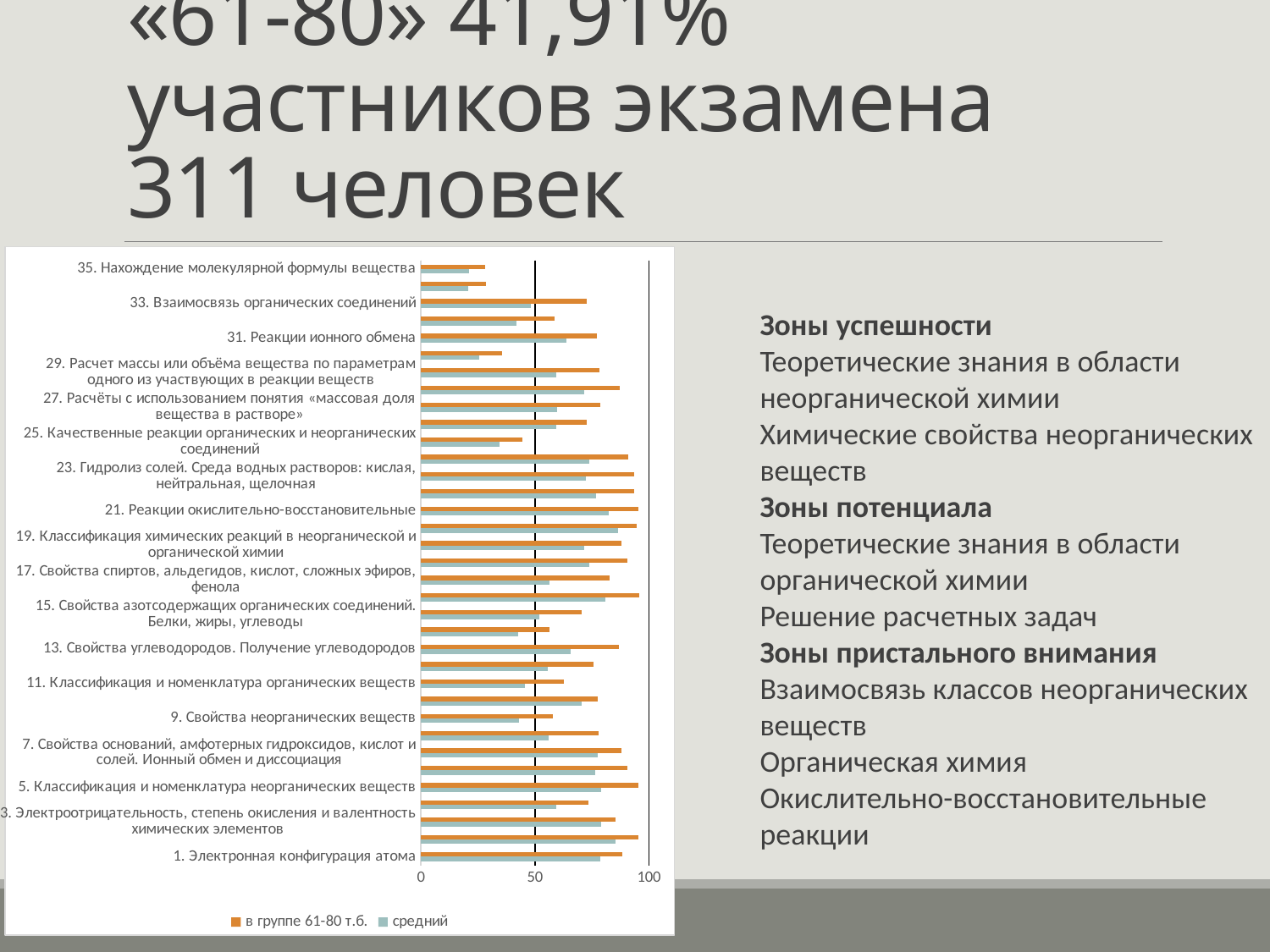
What are the two series named in the chart legend? в группе 61-80 т.б. and средний Is the value for '35. Нахождение молекулярной формулы вещества' in the series 'в группе 61-80 т.б.' greater or less than 50? less Is the value for '35. Нахождение молекулярной формулы вещества' in the series 'средний' greater or less than 50? less Which colour represents the series 'в группе 61-80 т.б.' in the chart? orange For '35. Нахождение молекулярной формулы вещества', which series has the larger value: 'в группе 61-80 т.б.' or 'средний'? в группе 61-80 т.б. Is the value for '15. Свойства азотсодержащих органических соединений. Белки, жиры, углеводы' in the series 'в группе 61-80 т.б.' greater or less than 50? greater Which labelled category has the lowest value in the series 'в группе 61-80 т.б.'? 35. Нахождение молекулярной формулы вещества For '29. Расчет массы или объёма вещества по параметрам одного из участвующих в реакции веществ', which series has the larger value: 'в группе 61-80 т.б.' or 'средний'? в группе 61-80 т.б. What kind of chart is shown on the slide? bar chart How many series does the chart legend list? 2